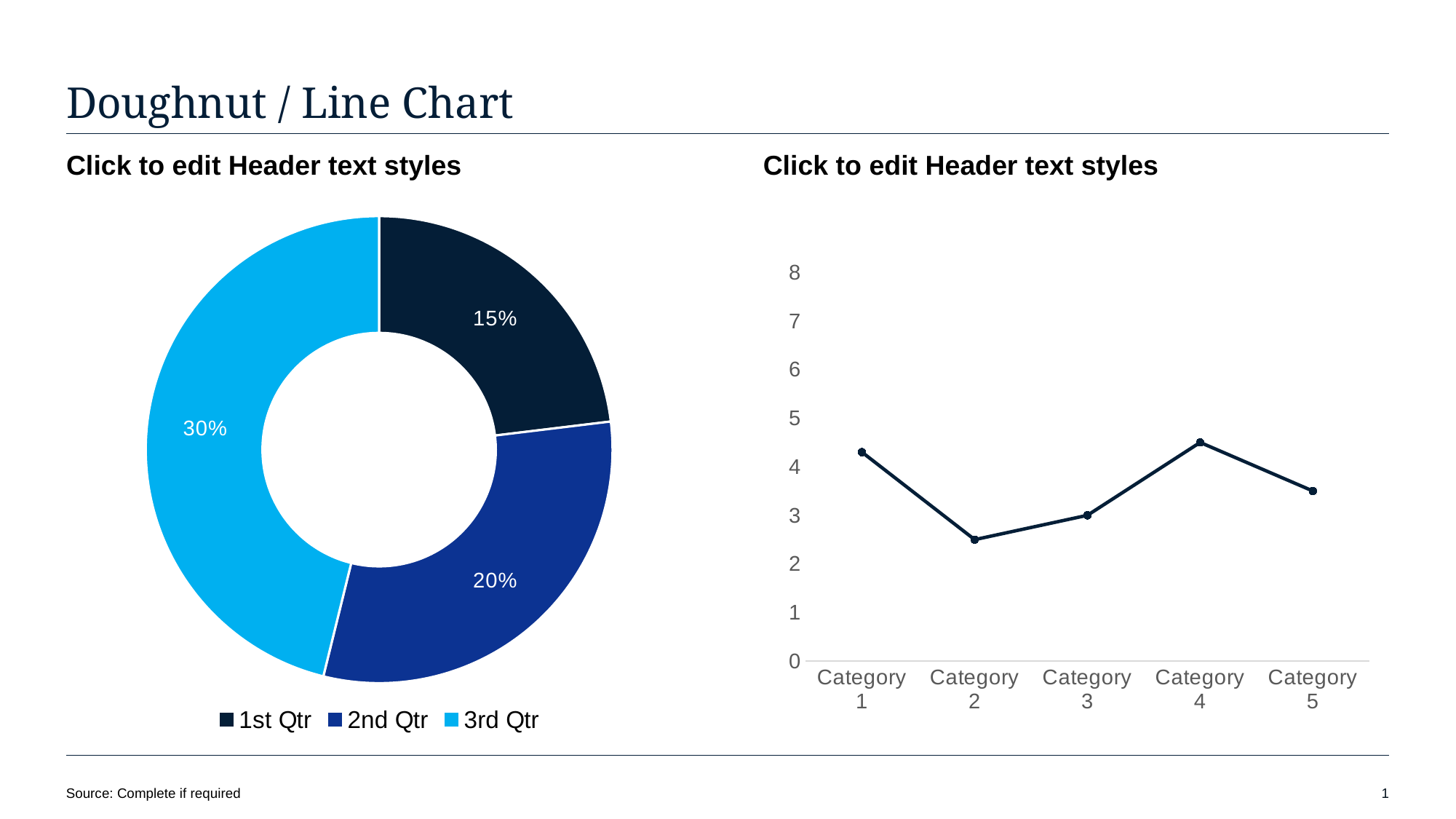
On the doughnut chart on the left, what is the difference between the 3rd Qtr and 1st Qtr values? 15% On the line chart on the right, is the value for Category 2 greater or less than 3? less On the doughnut chart on the left, what is the value shown for 2nd Qtr? 20% How many entries does the legend of the doughnut chart on the left list? 3 How many categories are plotted on the line chart on the right? 5 What kind of chart is shown on the right side of the slide? Line chart On the doughnut chart on the left, which quarter has the largest slice? 3rd Qtr On the line chart on the right, which category has the highest value? Category 4 On the doughnut chart on the left, what is the value shown for 3rd Qtr? 30% On the line chart on the right, which category has the lowest value? Category 2 On the doughnut chart on the left, which quarter has the smallest slice? 1st Qtr On the doughnut chart on the left, what is the value shown for 1st Qtr? 15%